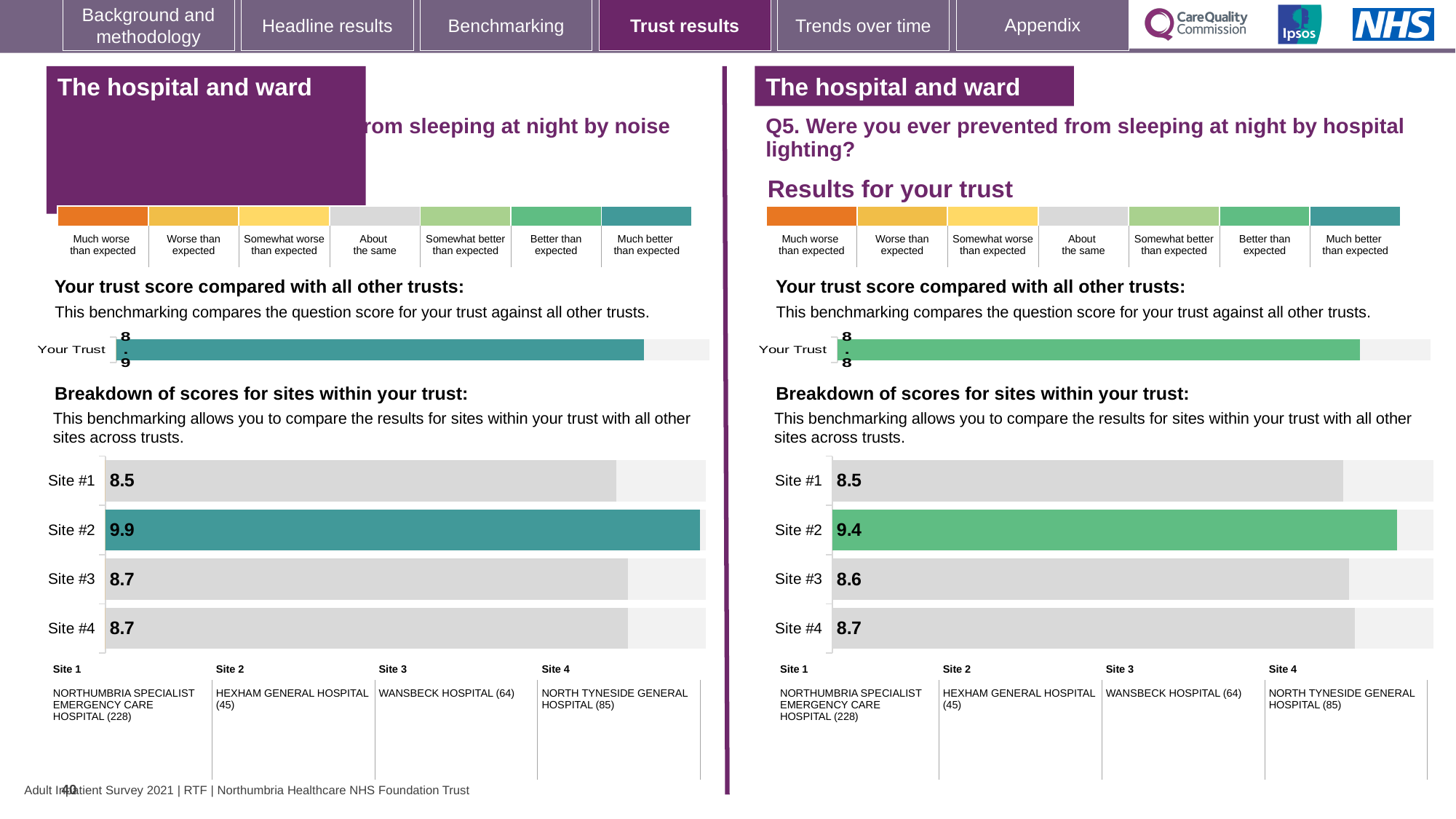
What type of chart is used for the site breakdown on the right-hand side (Q5, hospital lighting)? Bar chart On the right-hand site breakdown chart (Q5, hospital lighting), what is the difference between the scores for Site #4 and Site #1? 0.2 In the 'Your trust score compared with all other trusts' chart on the left-hand side (sleeping at night by noise), what is the trust score? 8.9 On the right-hand site breakdown chart (Q5, hospital lighting), which is larger: the score for Site #3 or Site #4? Site #4 On the left-hand site breakdown chart (sleeping at night by noise), what is the score for Site #2? 9.9 On the right-hand site breakdown chart (Q5, hospital lighting), what is the score for Site #3? 8.6 On the left-hand site breakdown chart (sleeping at night by noise), which site has the lowest score? Site #1 On the right-hand site breakdown chart (Q5, hospital lighting), what is the score for Site #2? 9.4 How many sites are shown in the left-hand site breakdown chart (sleeping at night by noise)? 4 On the right-hand site breakdown chart (Q5, hospital lighting), which site has the highest score? Site #2 On the left-hand site breakdown chart (sleeping at night by noise), what is the difference between the scores for Site #2 and Site #1? 1.4 In the 'Your trust score compared with all other trusts' chart on the right-hand side (Q5, hospital lighting), what is the trust score? 8.8